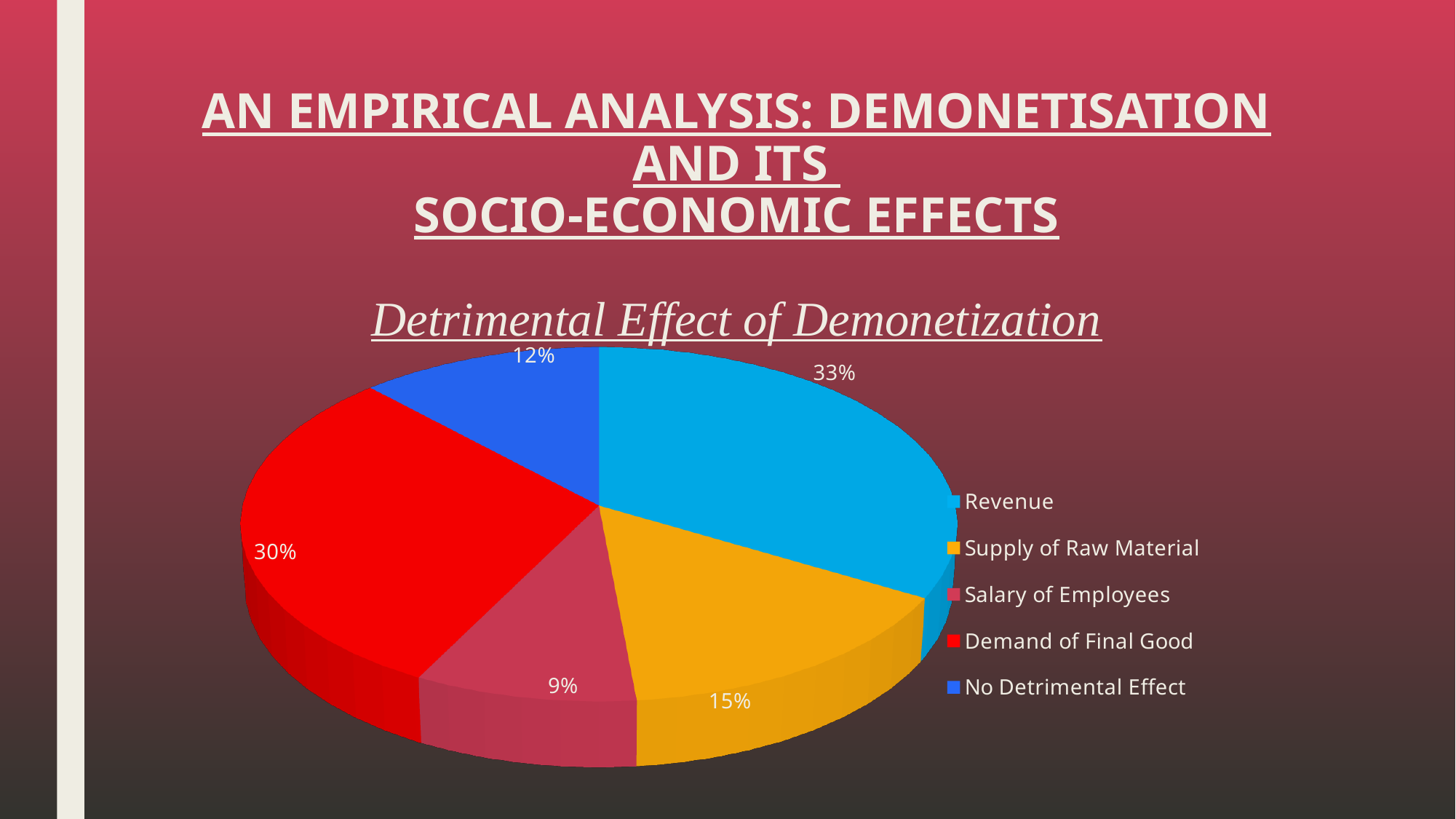
What is the difference in percentage points between Revenue and Demand of Final Good? 3 What share of the pie does No Detrimental Effect account for? 12% What share of the pie does Supply of Raw Material account for? 15% How many categories does the pie chart show? 5 Which category has the largest slice of the pie? Revenue Which category has the smallest slice of the pie? Salary of Employees What share of the pie does Revenue account for? 33% What share of the pie does Salary of Employees account for? 9% What share of the pie does Demand of Final Good account for? 30% Which is larger, Supply of Raw Material or No Detrimental Effect? Supply of Raw Material What is the title of the chart? Detrimental Effect of Demonetization What kind of chart is shown on the slide? Pie chart